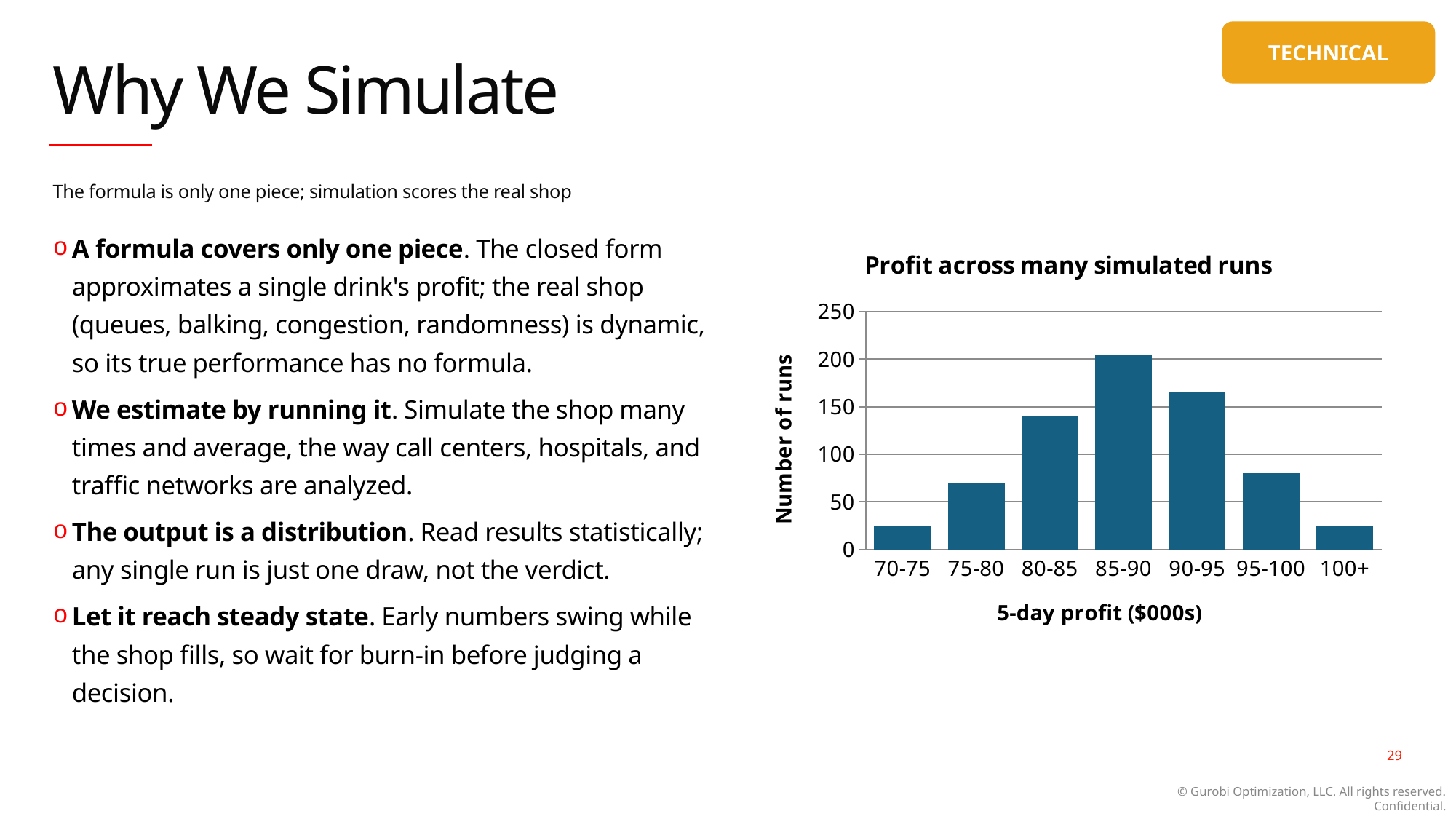
Is the number of runs for the 70-75 bin greater or less than 50? less What is the label of the x axis of the chart? 5-day profit ($000s) What is the title of the chart? Profit across many simulated runs Is the number of runs for the 80-85 bin greater or less than 150? less Do the number of runs rise or fall from the 85-90 bin to the 100+ bin? fall Is the number of runs for the 90-95 bin greater or less than 150? greater Which bin has more runs, 80-85 or 90-95? 90-95 Which profit bin has the highest number of runs? 85-90 How many profit bins are shown on the x axis of the chart? 7 What kind of chart is shown on the slide? bar chart